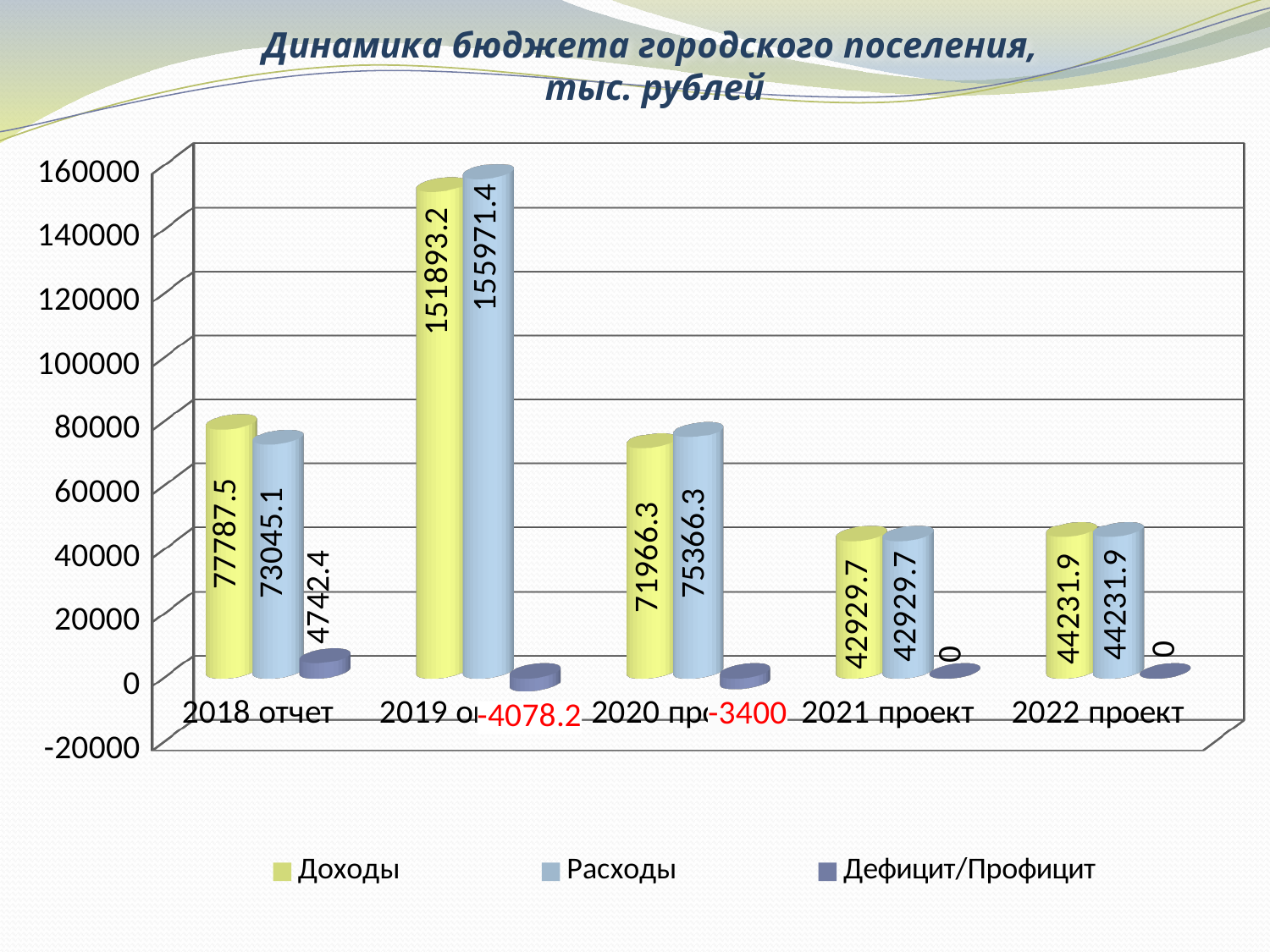
Which category has the highest value of Доходы? 2019 What is the difference between Расходы and Доходы for 2020? 3400 What is the value of Расходы for 2019? 155971.4 What is the value of Доходы for 2018 отчет? 77787.5 Which category has the lowest value of Расходы? 2021 проект What is the value of Расходы for 2022 проект? 44231.9 How many categories are shown on the x axis? 5 What is the title of the chart? Динамика бюджета городского поселения, тыс. рублей How many series does the legend list? 3 What kind of chart is shown on the slide? Bar chart Which is larger for 2018 отчет: Доходы or Расходы? Доходы What is the value of Дефицит/Профицит for 2020? -3400